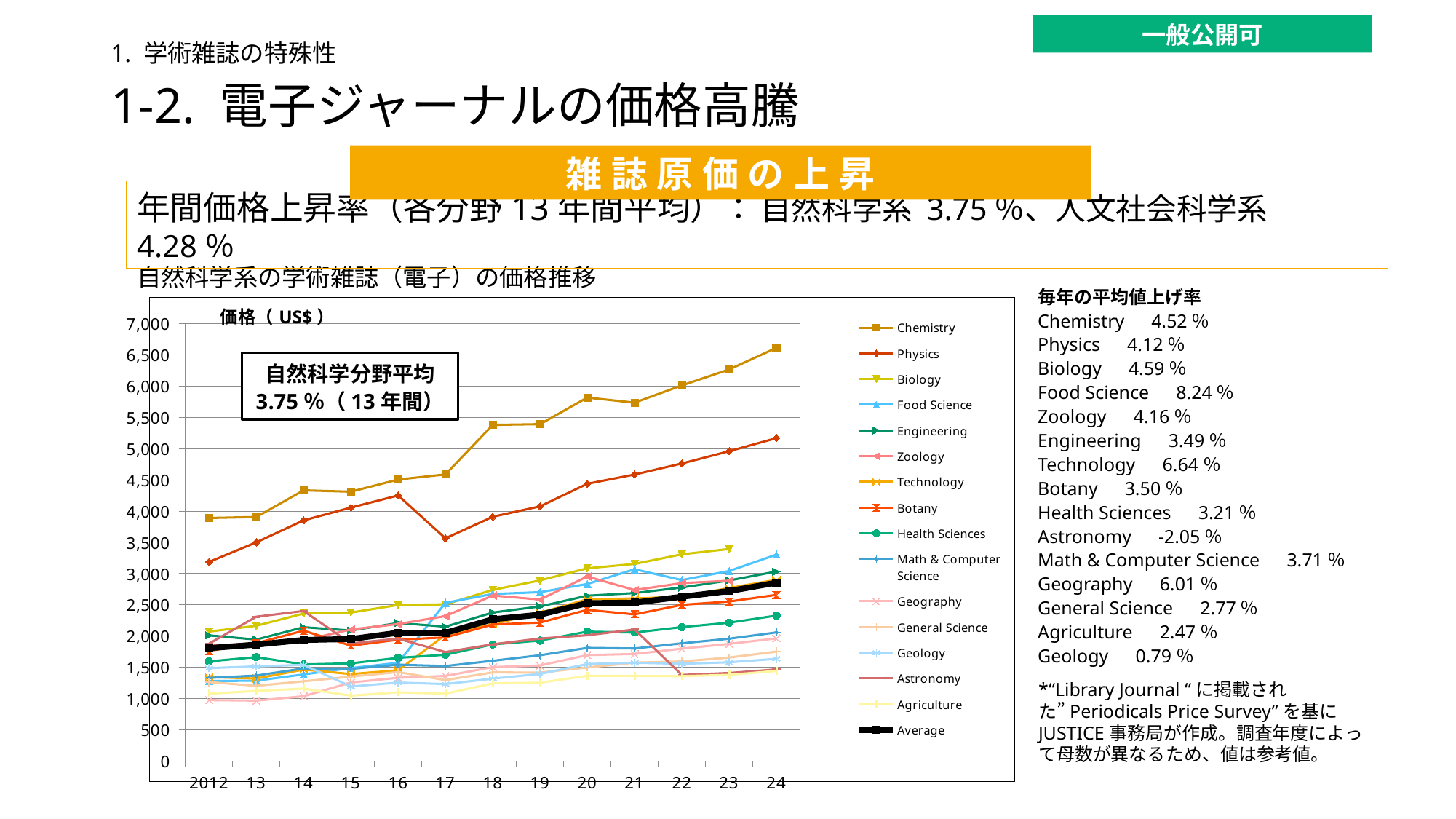
Is the Average value for 2012 greater or less than 2,000? less What unit label is shown at the top of the y axis? 価格（US$） Is the Physics value for 2024 greater or less than 5,000? greater How many years (x-axis points) are plotted on the chart? 13 Which series has the highest price in 2012? Chemistry What kind of chart is shown on the slide? line chart Which is larger in 2024, the Chemistry value or the Physics value? Chemistry Does the Chemistry line generally rise or fall from 2012 to 2024? rise Is the Chemistry value for 2024 greater or less than 6,500? greater How many series does the chart's legend list? 16 Which series has the highest price in 2024? Chemistry